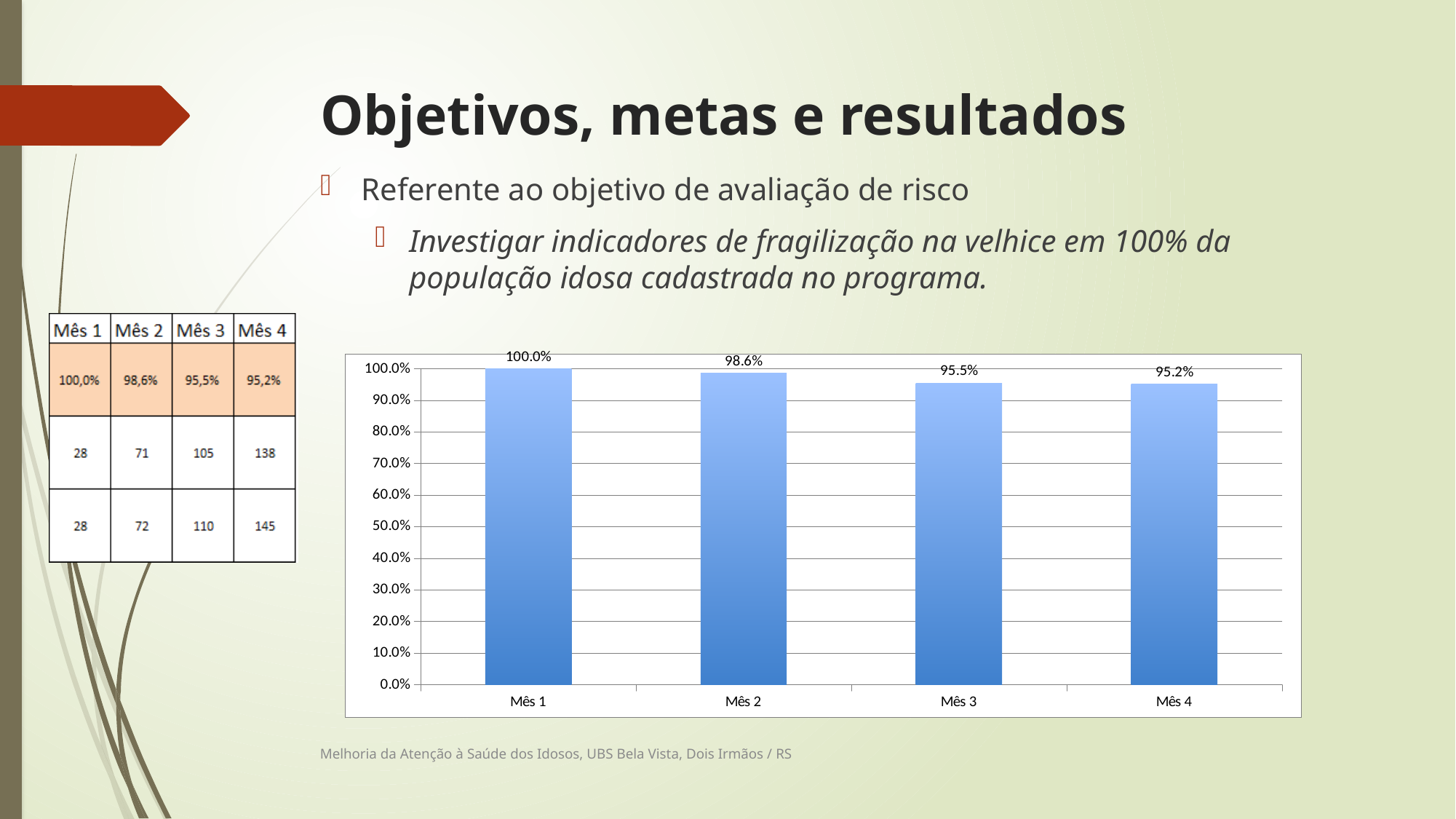
Do the values rise or fall from Mês 1 to Mês 4? Fall Which month has the lowest value? Mês 4 What is the value for Mês 1? 100.0% Which month has the highest value? Mês 1 What is the value for Mês 2? 98.6% What is the difference between the values for Mês 1 and Mês 4? 4.8% What is the value for Mês 4? 95.2% What kind of chart is shown on the slide? Bar chart What is the difference between the values for Mês 2 and Mês 3? 3.1% Which is larger, the value for Mês 2 or the value for Mês 3? Mês 2 How many months are shown on the x axis of the chart? 4 What is the value for Mês 3? 95.5%